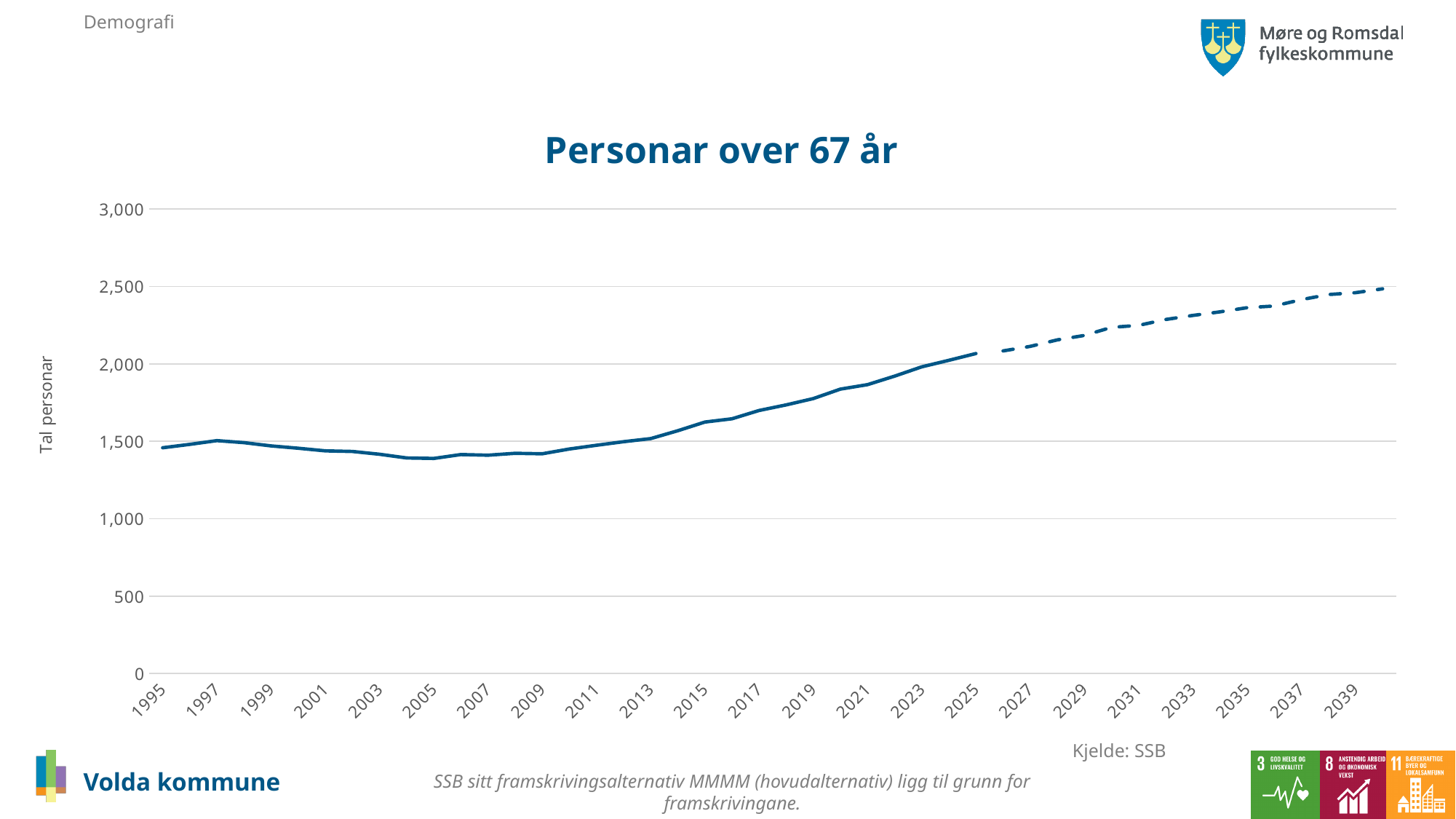
Around which year does the line reach its lowest value? 2005 Is the value for 2031 greater or less than 2,000? greater What is the label on the vertical axis of the chart? Tal personar Is the value for 2015 greater or less than 1,500? greater Does the line generally rise or fall from 2009 to 2039? rise Which is larger, the value for 1997 or the value for 2005? 1997 Is the value for 2005 greater or less than 1,500? less What kind of chart is shown on the slide? line chart What is the title of the chart? Personar over 67 år Which is larger, the value for 1995 or the value for 2025? 2025